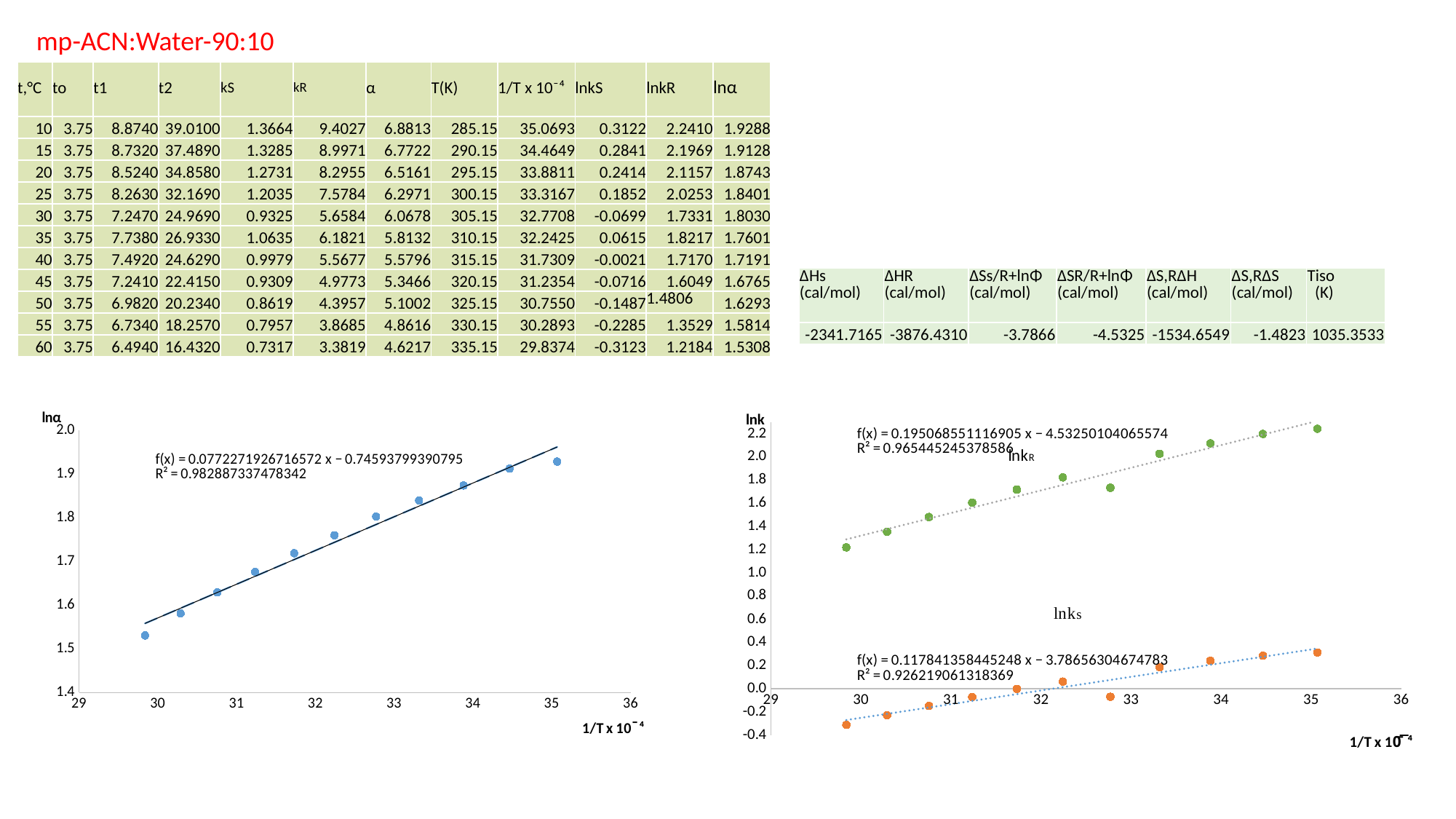
How many data series are plotted in the right chart titled lnk? 2 What kind of chart is the left chart titled lnα? scatter chart In the left chart (lnα), is the value of the leftmost point (near 1/T x 10⁻⁴ = 30) greater or less than 1.6? less In the left chart (lnα), do the plotted values rise or fall as 1/T x 10⁻⁴ increases from 29 to 36? rise What R² value is shown for the lnkR trendline in the right chart (lnk)? 0.965445245378586 In the right chart (lnk), which series has the larger values, lnkR or lnkS? lnkR What R² value is shown for the trendline in the left chart (lnα)? 0.982887337478342 How many data points are plotted in the left chart (lnα)? 11 In the right chart (lnk), is the lowest lnkS point (near 1/T x 10⁻⁴ = 30) greater or less than -0.2? less In the right chart (lnk), is the highest lnkR point (near 1/T x 10⁻⁴ = 35) greater or less than 2.0? greater In the right chart (lnk), do the lnkS values rise or fall as 1/T x 10⁻⁴ increases? rise